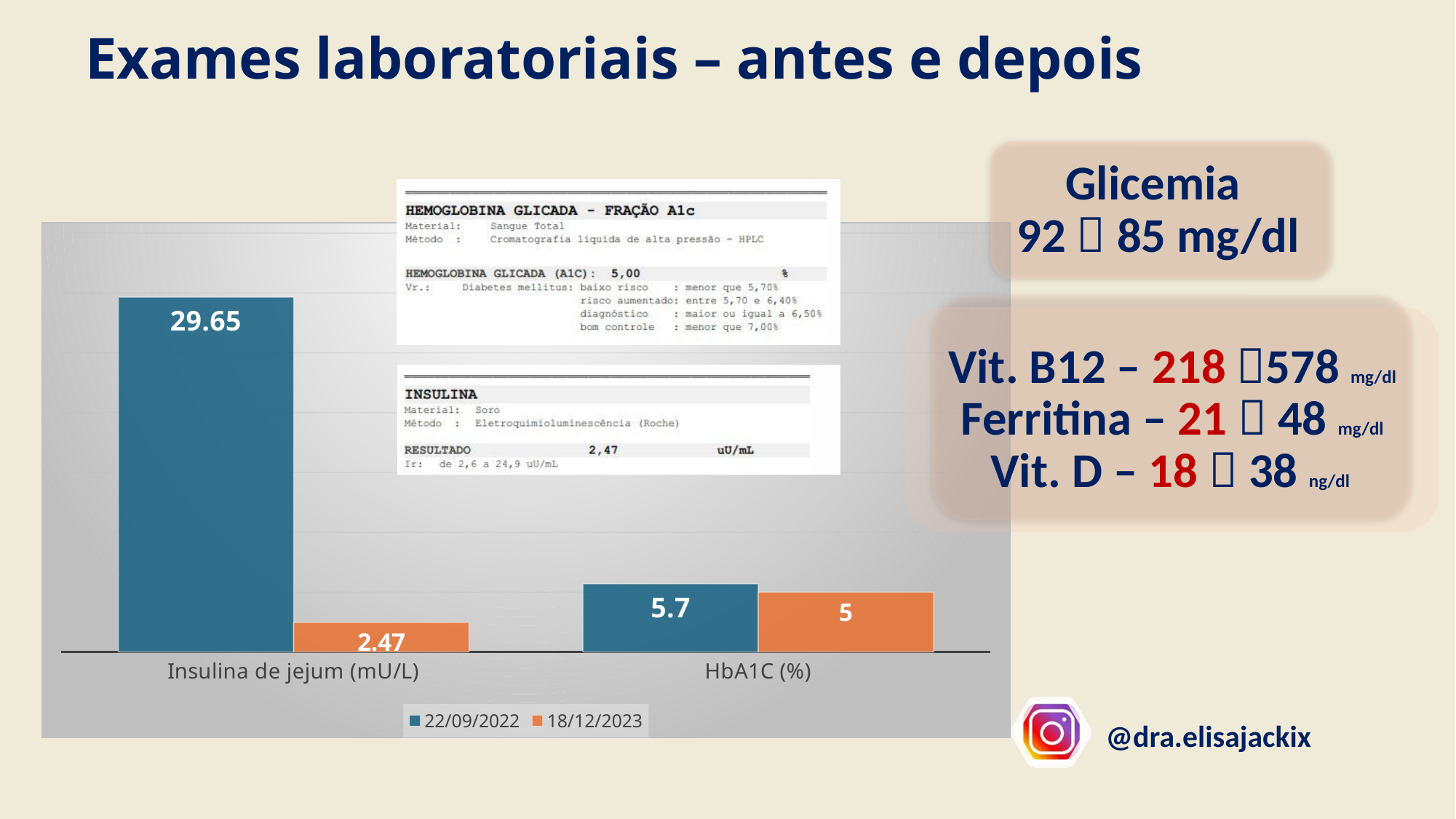
What is the value for HbA1C (%) in the 22/09/2022 series? 5.7 What colour are the bars for the 18/12/2023 series? orange What is the value for Insulina de jejum (mU/L) in the 22/09/2022 series? 29.65 What is the value for Insulina de jejum (mU/L) in the 18/12/2023 series? 2.47 What is the value for HbA1C (%) in the 18/12/2023 series? 5 Which bar in the chart has the highest value? Insulina de jejum (mU/L), 22/09/2022 How many series does the legend list? 2 What is the difference between the 22/09/2022 and 18/12/2023 values for Insulina de jejum (mU/L)? 27.18 Which bar in the chart has the lowest value? Insulina de jejum (mU/L), 18/12/2023 Which is larger for HbA1C (%): the 22/09/2022 value or the 18/12/2023 value? 22/09/2022 What type of chart is shown on the slide? bar chart How many categories are shown on the x axis of the chart? 2